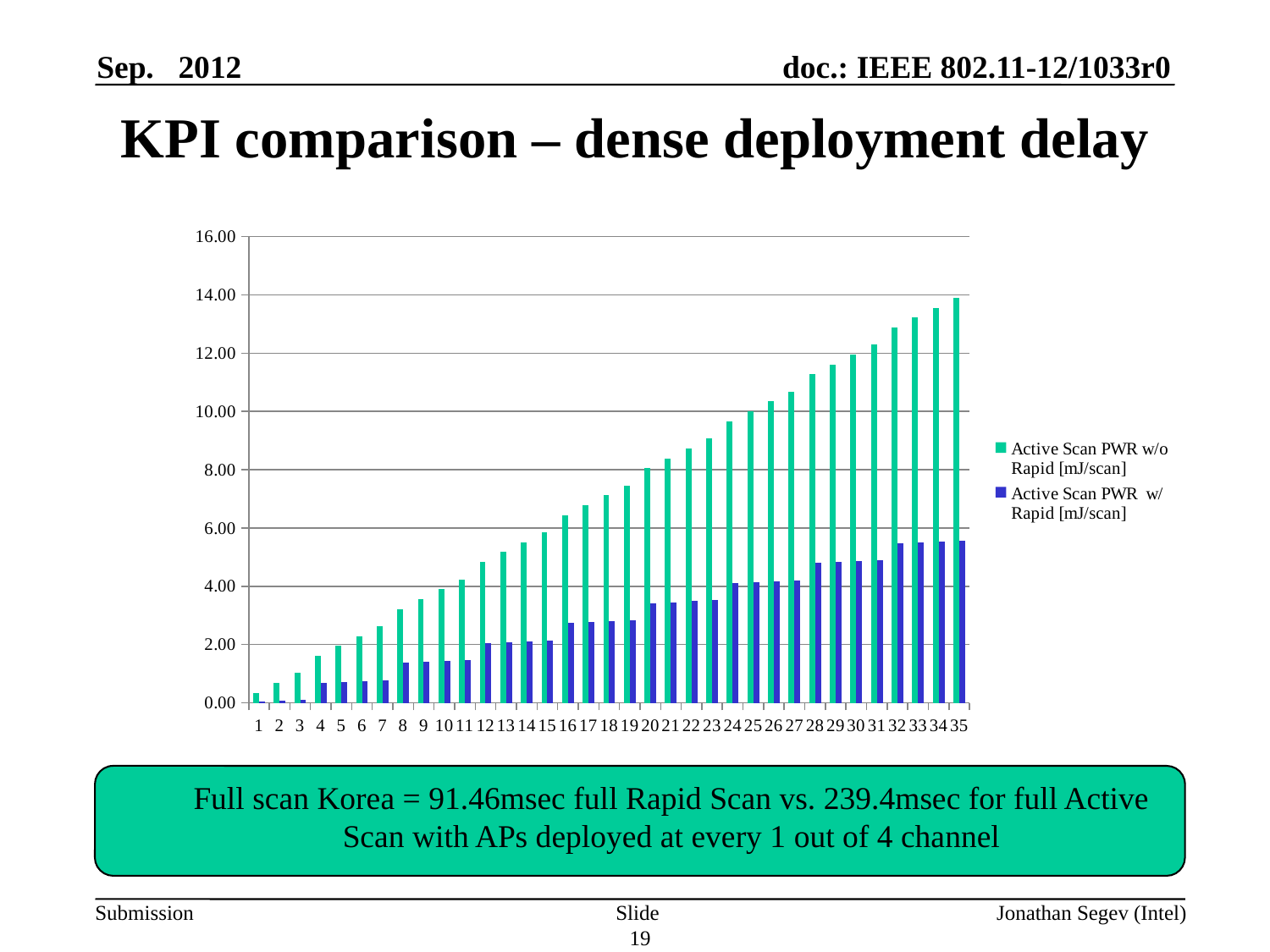
For Active Scan PWR w/o Rapid [mJ/scan], which is larger: the value at category 20 or the value at category 10? category 20 Is the value for Active Scan PWR w/o Rapid [mJ/scan] at category 28 greater or less than 10.00? greater How many series does the legend list? 2 What kind of chart is shown on the slide? bar chart Which category has the highest value for Active Scan PWR w/o Rapid [mJ/scan]? 35 Which category has the lowest value for Active Scan PWR w/o Rapid [mJ/scan]? 1 Do the values for Active Scan PWR w/o Rapid [mJ/scan] rise or fall as the category number increases from 1 to 35? rise How many categories are shown along the x axis? 35 Is the value for Active Scan PWR w/o Rapid [mJ/scan] at category 35 greater or less than 12.00? greater Is the value for Active Scan PWR w/ Rapid [mJ/scan] at category 20 greater or less than 4.00? less At category 35, which series has the larger value: Active Scan PWR w/o Rapid [mJ/scan] or Active Scan PWR w/ Rapid [mJ/scan]? Active Scan PWR w/o Rapid [mJ/scan] What colour are the bars for the Active Scan PWR w/ Rapid [mJ/scan] series? blue